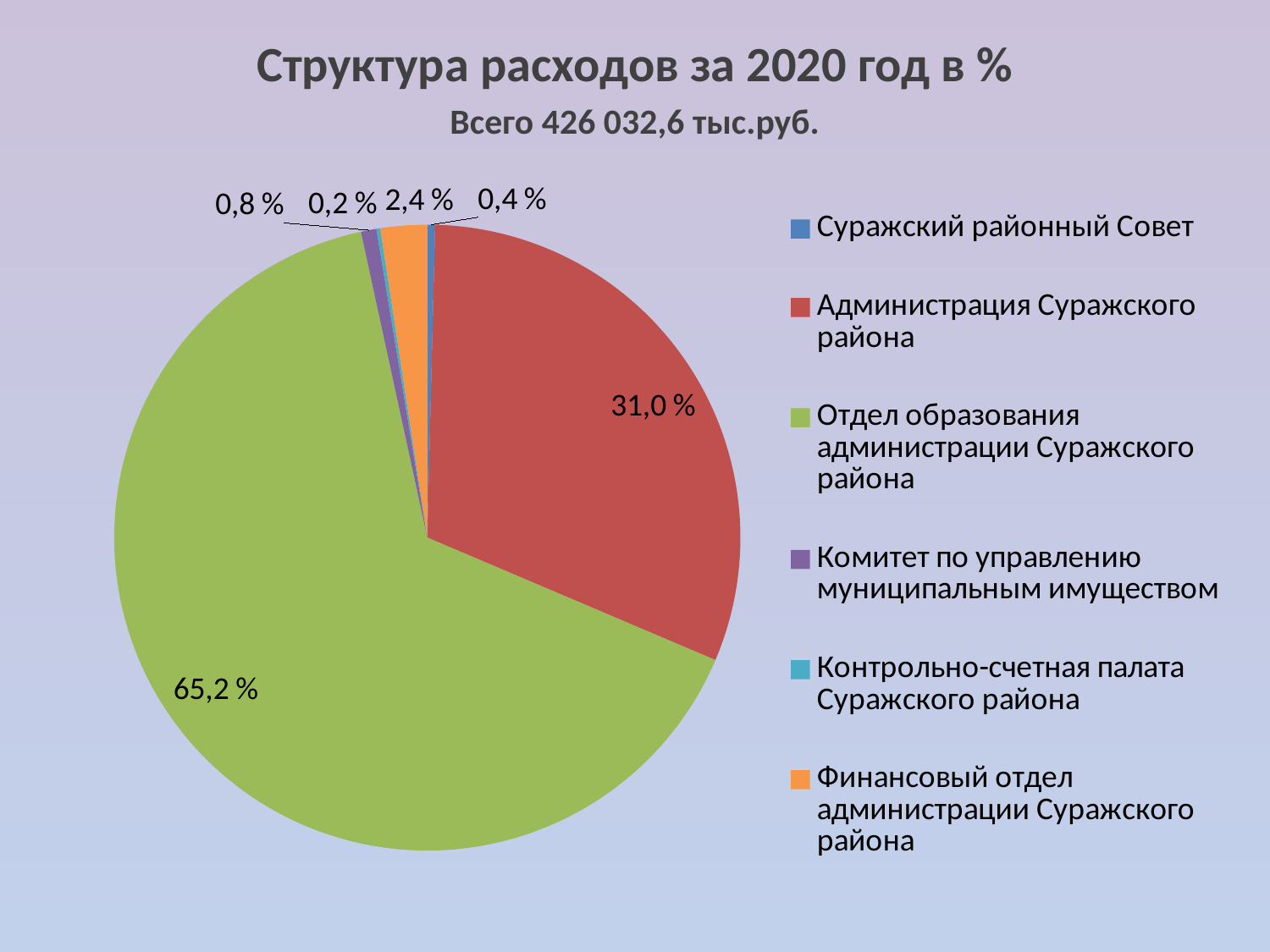
What share of expenses does Отдел образования администрации Суражского района account for? 65,2 % Which category has the smallest share of expenses? Контрольно-счетная палата Суражского района What share of expenses does Финансовый отдел администрации Суражского района account for? 2,4 % What share of expenses does Контрольно-счетная палата Суражского района account for? 0,2 % What share of expenses does Комитет по управлению муниципальным имуществом account for? 0,8 % What kind of chart is shown on the slide? pie chart How many categories does the pie chart show? 6 What total amount of expenses is stated under the chart title? 426 032,6 тыс.руб. What share of expenses does Администрация Суражского района account for? 31,0 % What share of expenses does Суражский районный Совет account for? 0,4 % What is the difference in percentage points between the shares of Отдел образования администрации Суражского района and Администрация Суражского района? 34,2 Which category has the largest share of expenses? Отдел образования администрации Суражского района